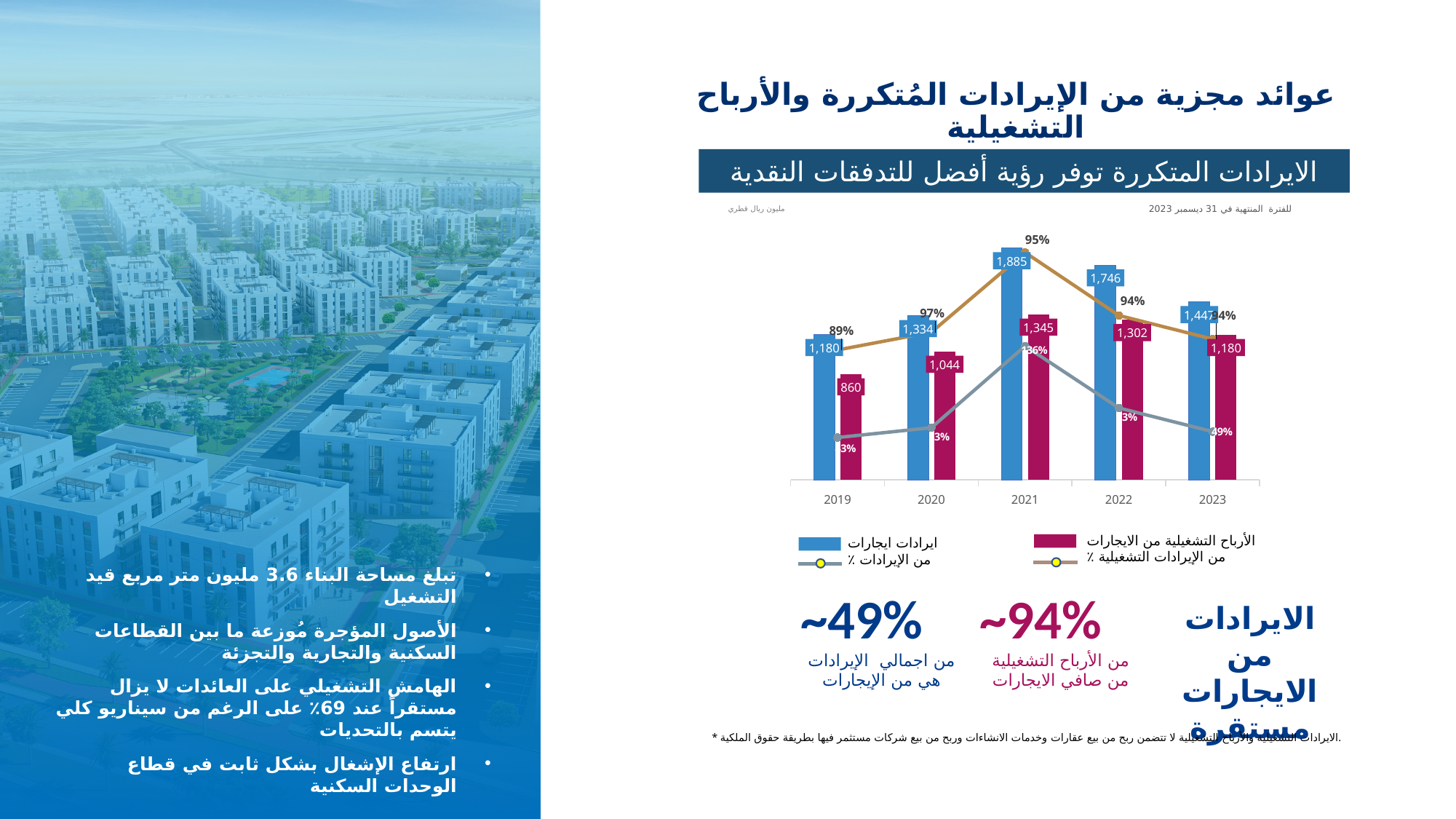
What is the operating profit from rentals (red bar) value for 2019? 860 What is the difference between the operating profit from rentals in 2021 and in 2019? 485 Which year has the larger operating profit from rentals (red bar), 2022 or 2023? 2022 Which year has the highest rental revenue (blue bar)? 2021 What is the difference between the rental revenue in 2021 and in 2020? 551 What percentage is shown on the orange line for 2019? 89% How many series does the chart legend list? 4 How many years are shown on the x axis of the chart? 5 What percentage is shown on the orange line for 2020? 97% Which year has the lowest operating profit from rentals (red bar)? 2019 Does the rental revenue (blue bar) rise or fall from 2019 to 2021? rise What is the rental revenue (blue bar) value for 2021? 1,885